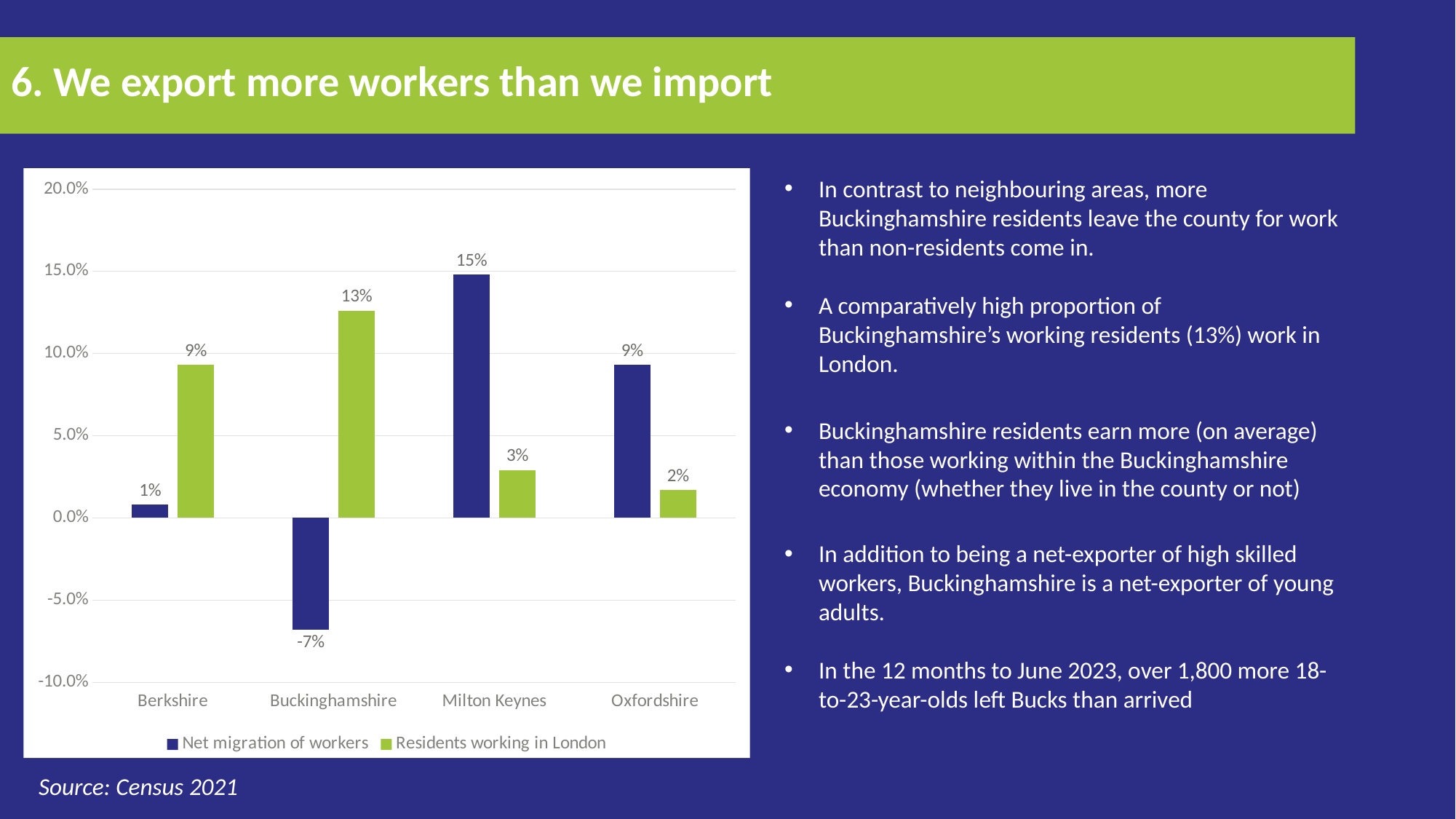
What percentage of Buckinghamshire residents work in London according to the chart? 13% Which area has the highest proportion of residents working in London? Buckinghamshire Which area has the highest net migration of workers? Milton Keynes How many series does the chart legend list? 2 How many areas are shown on the x axis of the chart? 4 What is the difference between the net migration of workers for Milton Keynes and Oxfordshire, using the printed labels? 6 percentage points Which is larger for Berkshire: net migration of workers or residents working in London? Residents working in London Which area has the lowest net migration of workers? Buckinghamshire What is the 'Residents working in London' value for Oxfordshire? 2% What is the net migration of workers value for Milton Keynes? 15% What type of chart is shown on the slide? Bar chart What is the net migration of workers value for Buckinghamshire? -7%